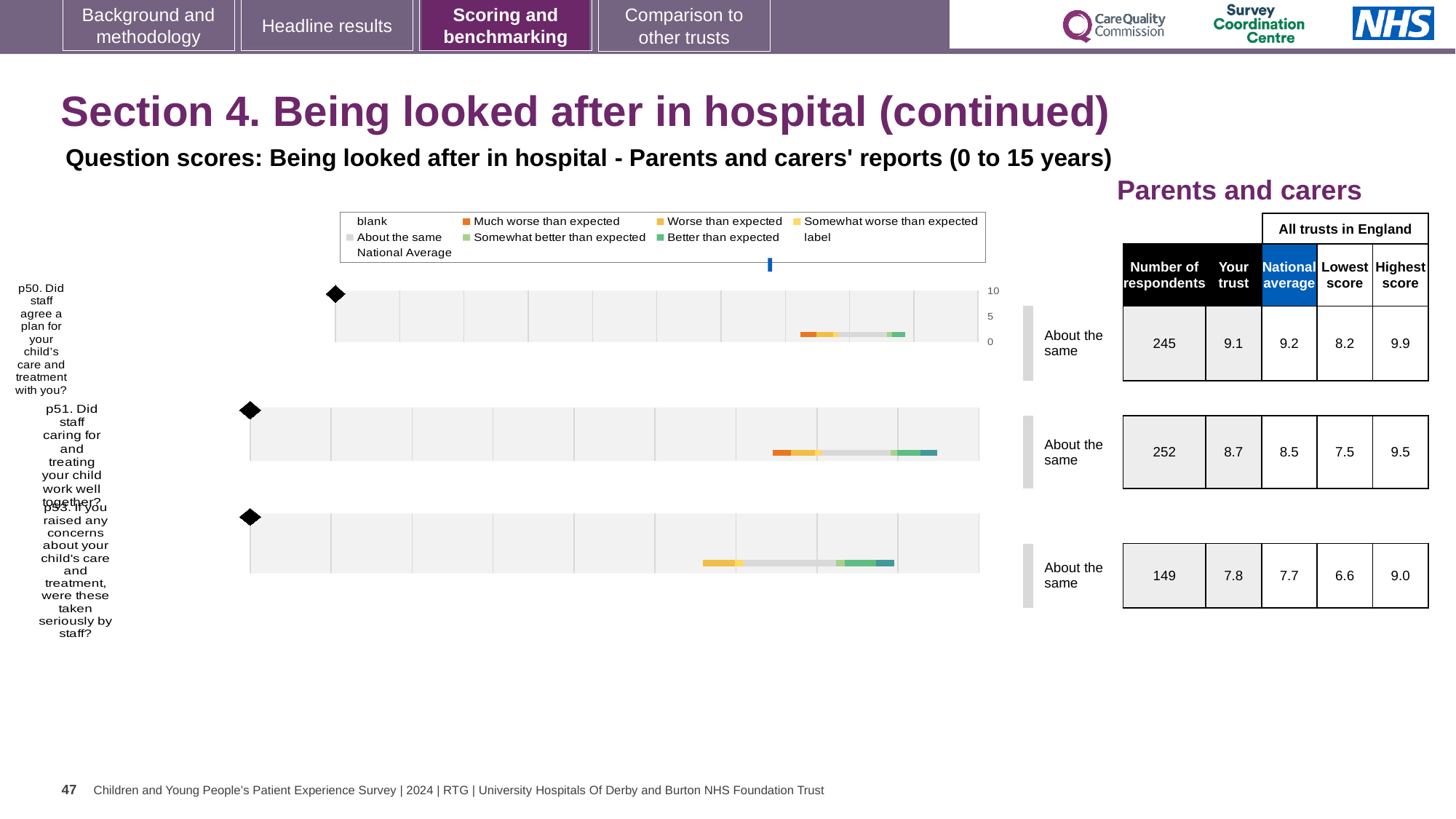
Which question has the lowest number of respondents on this slide? p53 How many questions (p50, p51, p53) are plotted as separate bars on the slide? 3 What is the difference between the highest score and the lowest score for p50? 1.7 What benchmark category is shown for p50 on this slide? About the same For p51, which is larger: the 'Your trust' score or the national average? Your trust How many respondents answered p53 (If you raised any concerns about your child's care and treatment, were these taken seriously by staff?)? 149 What is the 'Your trust' score for p50 (Did staff agree a plan for your child's care and treatment with you?)? 9.1 Which question has the highest 'Your trust' score on this slide? p50 What is the national average score for p51 (Did staff caring for and treating your child work well together?)? 8.5 What is the difference between the 'Your trust' score and the national average for p53? 0.1 Which legend entry is shown in orange on the chart? Much worse than expected What kind of chart is used to show the question scores on this slide? Bar chart